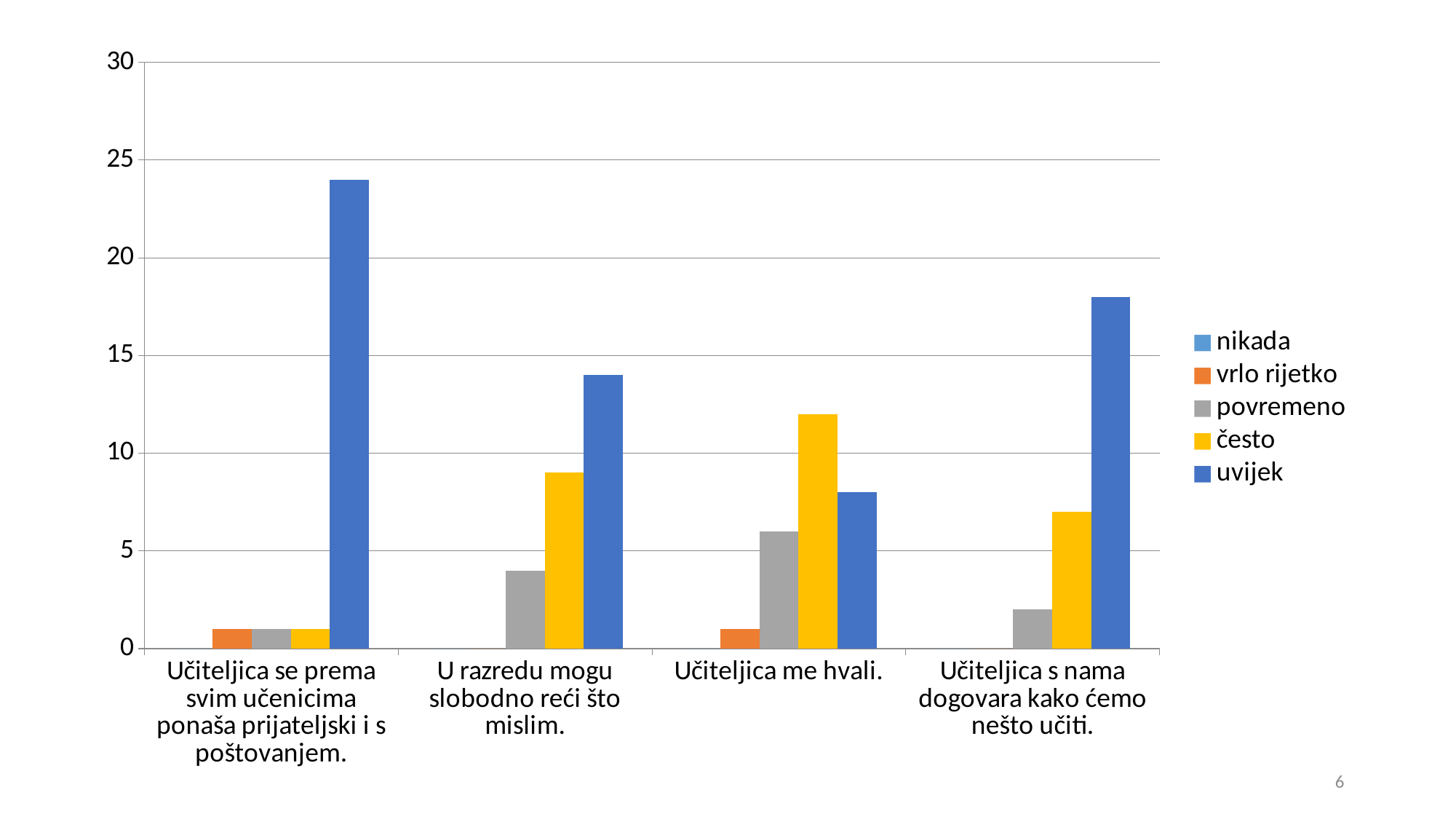
What colour represents the 'često' series in the legend? yellow Is the 'često' value for 'Učiteljica me hvali.' greater or less than 10? greater Which has the larger 'uvijek' value: 'U razredu mogu slobodno reći što mislim.' or 'Učiteljica s nama dogovara kako ćemo nešto učiti.'? Učiteljica s nama dogovara kako ćemo nešto učiti. How many series does the legend list? 5 Is the 'uvijek' value for 'Učiteljica se prema svim učenicima ponaša prijateljski i s poštovanjem.' greater or less than 20? greater Which category has the highest 'uvijek' bar? Učiteljica se prema svim učenicima ponaša prijateljski i s poštovanjem. What kind of chart is shown on the slide? bar chart How many categories are shown along the x axis? 4 For 'Učiteljica me hvali.', which is larger: 'često' or 'uvijek'? često Is the 'uvijek' value for 'U razredu mogu slobodno reći što mislim.' greater or less than 10? greater Which category has the lowest 'uvijek' bar? Učiteljica me hvali.